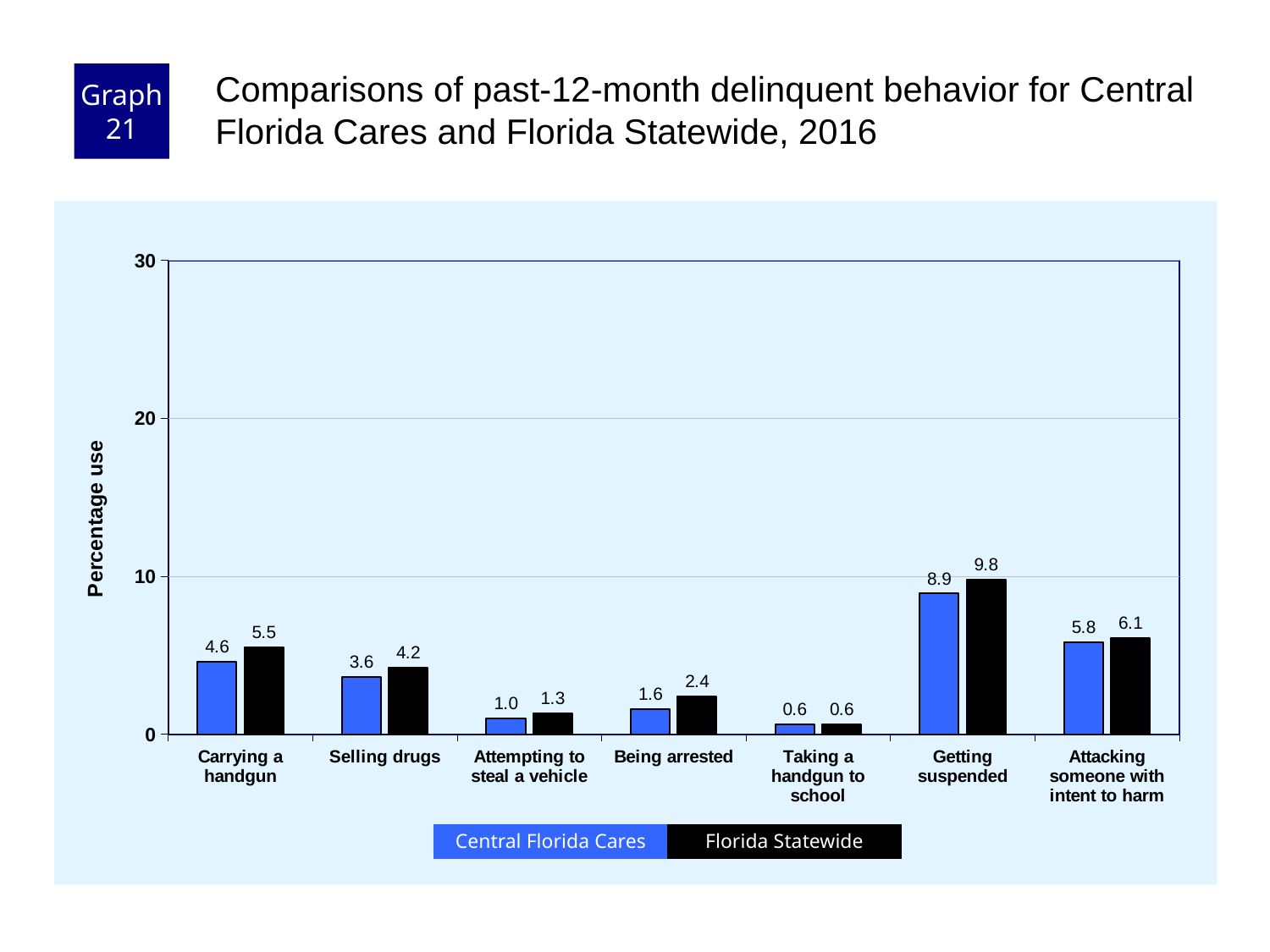
How many series does the legend list? 2 What kind of chart is shown on the slide? Bar chart Which category has the highest Florida Statewide value? Getting suspended What is the Florida Statewide value for Being arrested? 2.4 What is the label of the y axis? Percentage use Which category has the lowest Central Florida Cares value? Taking a handgun to school How many categories are shown on the x axis? 7 Is the Florida Statewide value for Getting suspended greater or less than 10? less What is the Central Florida Cares value for Getting suspended? 8.9 What is the difference between the Florida Statewide and Central Florida Cares values for Carrying a handgun? 0.9 What is the Central Florida Cares value for Carrying a handgun? 4.6 Which is larger for Selling drugs: the Central Florida Cares value or the Florida Statewide value? Florida Statewide